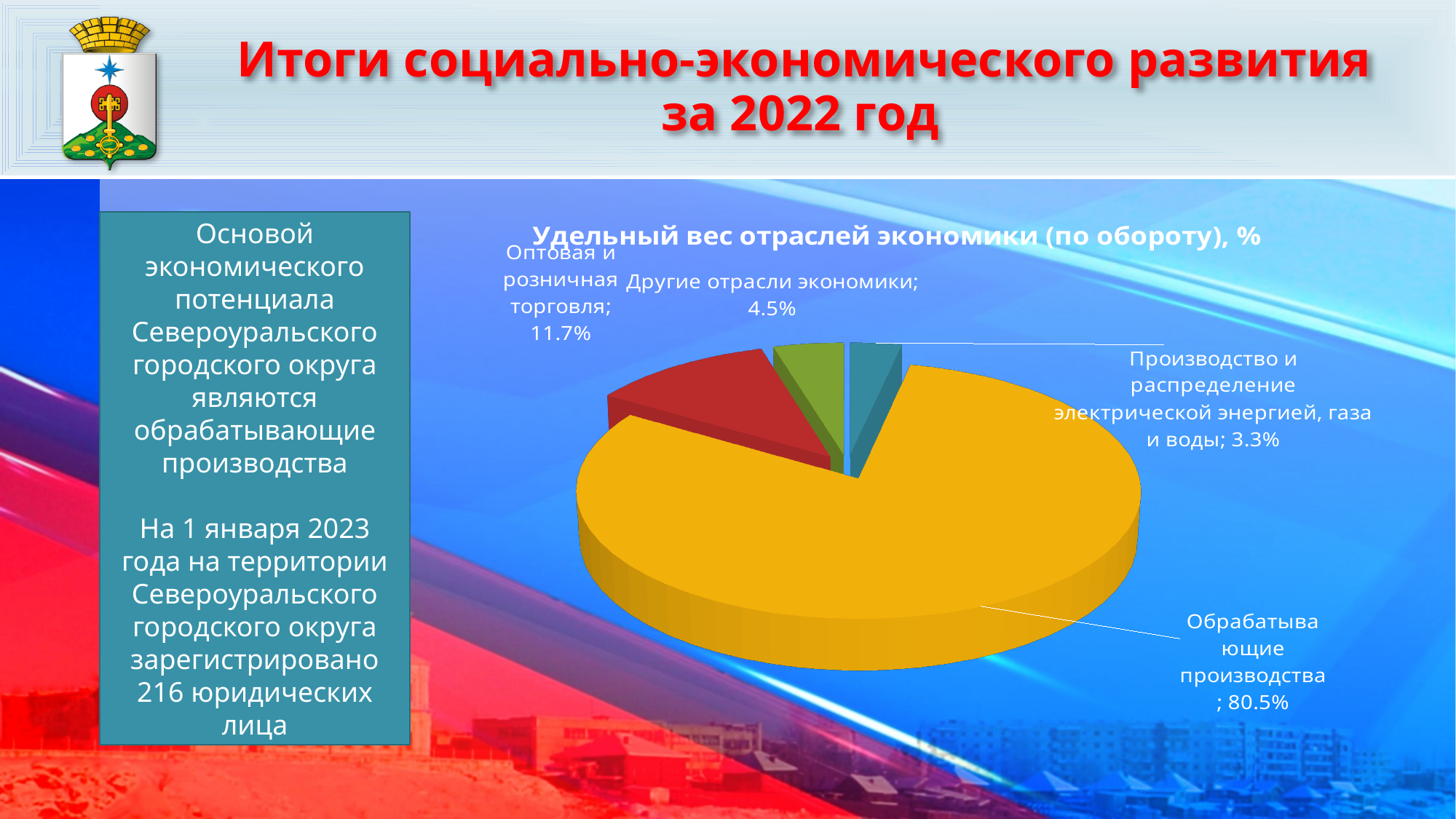
What share does "Обрабатывающие производства" have in the pie chart? 80.5% Which sector has the largest share in the pie chart? Обрабатывающие производства Which is larger: the share of "Другие отрасли экономики" or the share of "Производство и распределение электрической энергией, газа и воды"? Другие отрасли экономики What colour is the slice for "Обрабатывающие производства"? Yellow What is the title of the chart? Удельный вес отраслей экономики (по обороту), % Which sector has the smallest share in the pie chart? Производство и распределение электрической энергией, газа и воды How many slices does the pie chart have? 4 What share does "Оптовая и розничная торговля" have in the pie chart? 11.7% What share does "Производство и распределение электрической энергией, газа и воды" have in the pie chart? 3.3% What share does "Другие отрасли экономики" have in the pie chart? 4.5% What is the difference in percentage points between "Обрабатывающие производства" and "Оптовая и розничная торговля"? 68.8 What type of chart is shown on the slide? Pie chart